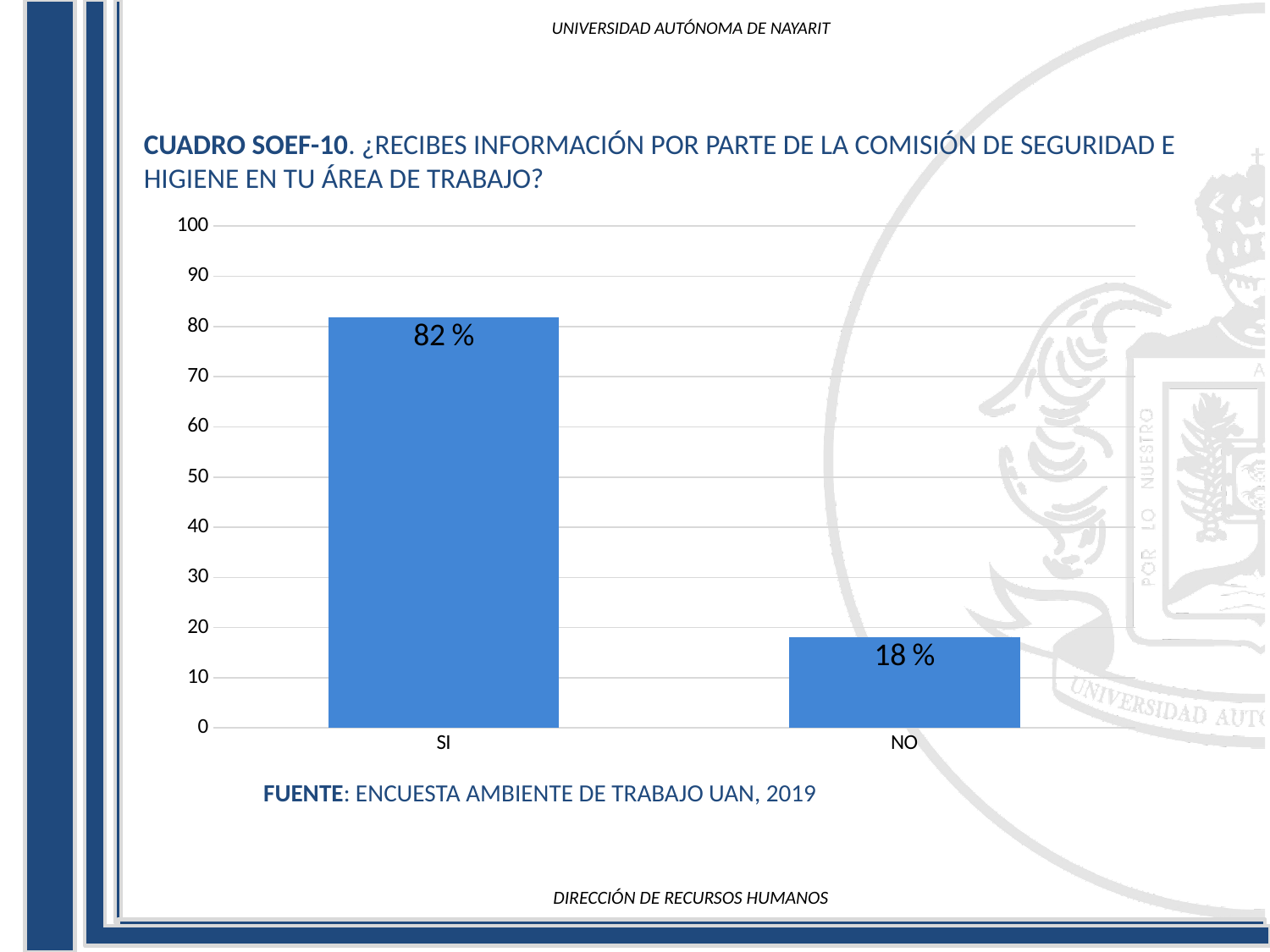
What is the maximum value shown on the vertical axis? 100 What is the difference between the values for SI and NO? 64 % Which is larger, the value for SI or the value for NO? SI Which category has the highest value? SI Is the value for NO greater or less than 20? less What source is cited below the chart? ENCUESTA AMBIENTE DE TRABAJO UAN, 2019 What is the value for NO? 18 % How many categories are shown on the x axis? 2 What kind of chart is shown on the slide? bar chart Is the value for SI greater or less than 80? greater What is the value for SI? 82 % Which category has the lowest value? NO